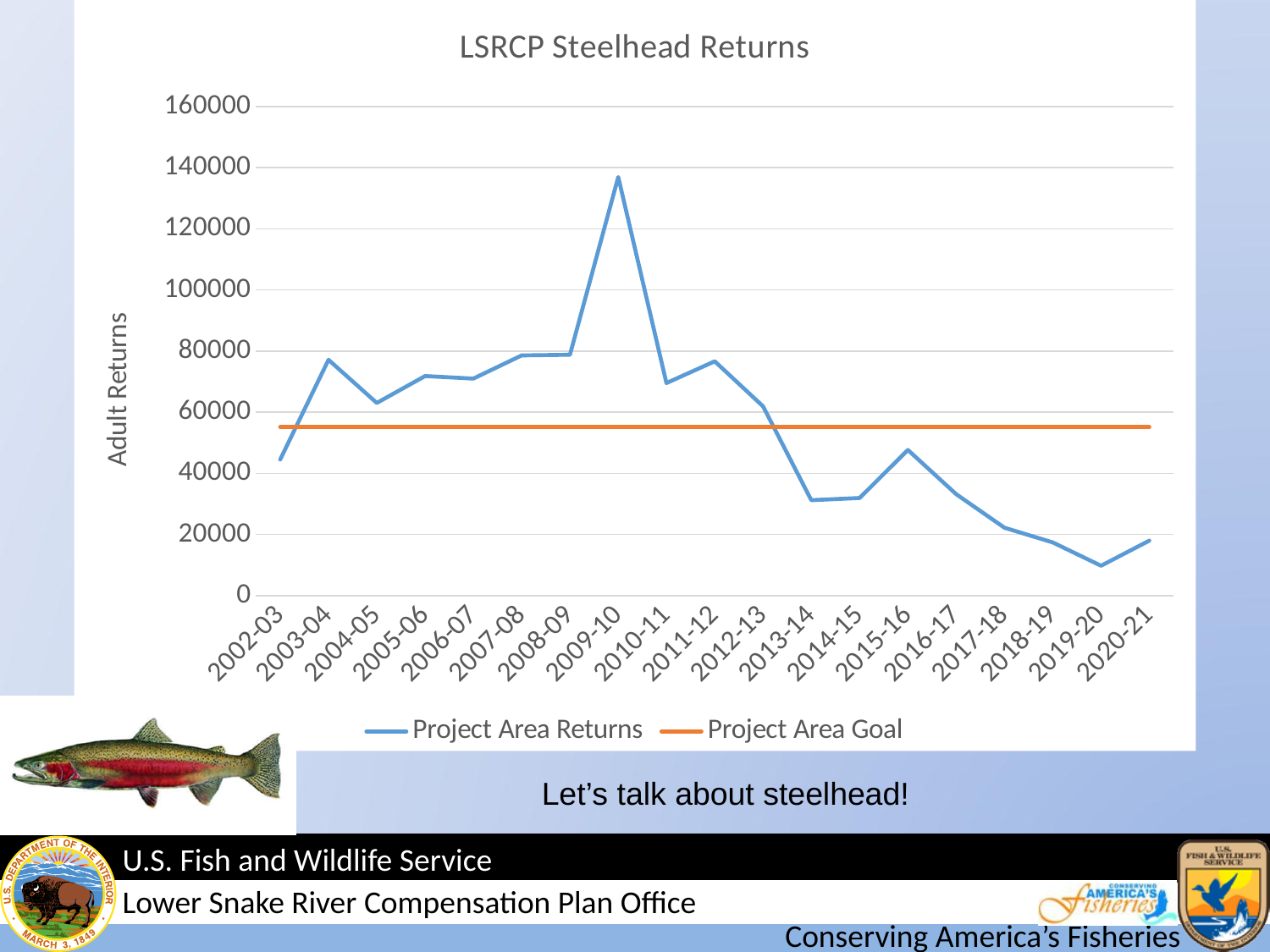
Which is larger, Project Area Returns in 2015-16 or in 2017-18? 2015-16 In which year are Project Area Returns highest? 2009-10 How many series does the legend list? 2 Do Project Area Returns generally rise or fall from 2011-12 to 2019-20? fall Is the value for Project Area Returns in 2013-14 greater or less than 40000? less Is the value for Project Area Returns in 2009-10 greater or less than 120000? greater How many years (categories) are shown on the x axis? 19 What kind of chart is shown on the slide? line chart In which year are Project Area Returns lowest? 2019-20 Is the value for Project Area Returns in 2002-03 greater or less than the Project Area Goal? less What is the title of the chart? LSRCP Steelhead Returns What is the label of the y axis? Adult Returns